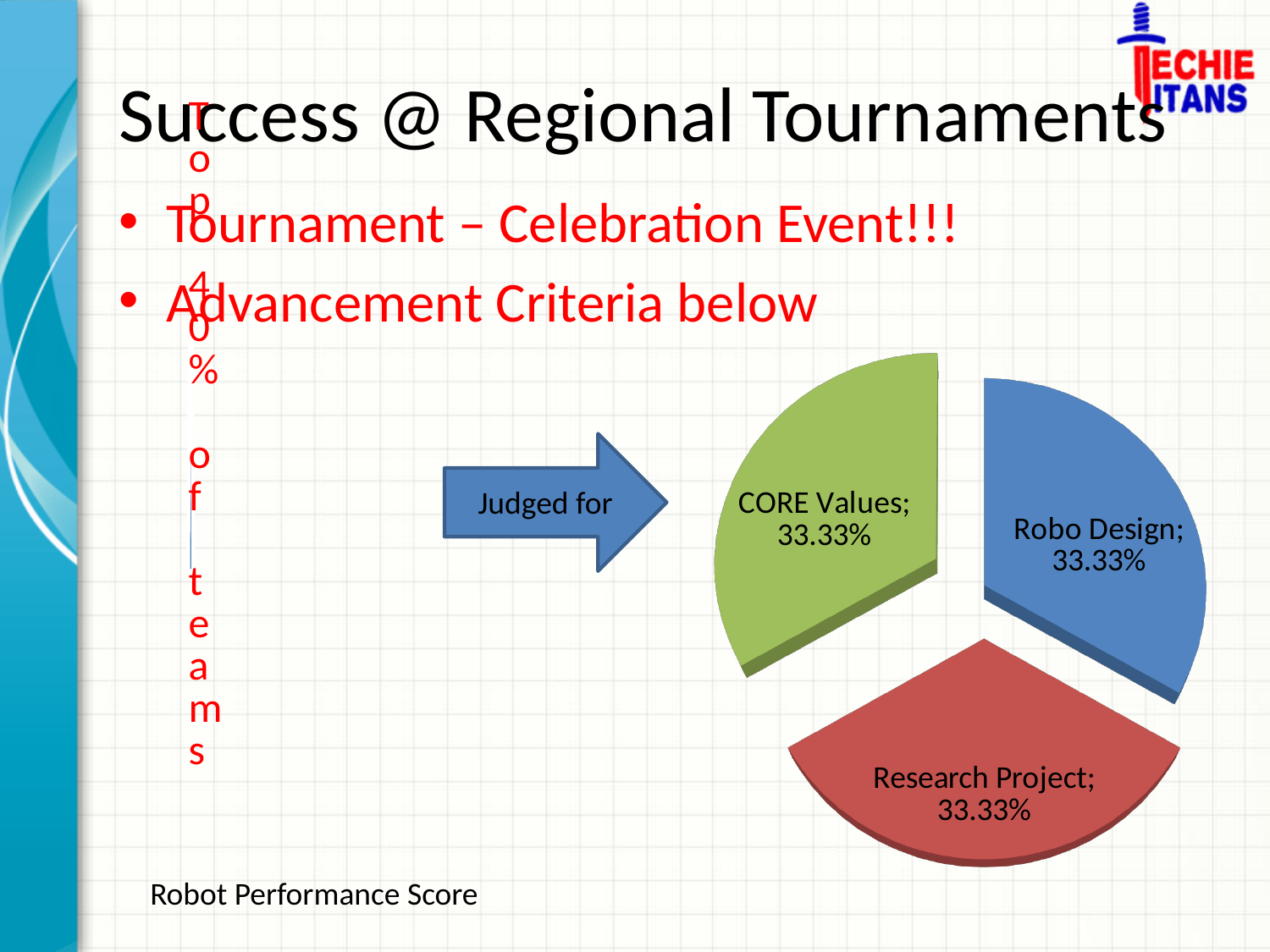
Which slice of the pie chart is coloured green? CORE Values What share of the pie does Robo Design represent? 33.33% What kind of chart is shown on the slide? pie chart Which categories are shown in the pie chart? CORE Values, Robo Design, Research Project What share of the pie does CORE Values represent? 33.33% What share of the pie does Research Project represent? 33.33% Which slice of the pie chart is coloured red? Research Project What is the difference between the Robo Design share and the CORE Values share? 0% How many slices does the pie chart have? 3 Are the three slices of the pie chart equal in size? yes Is the share for Research Project greater or less than 50%? less